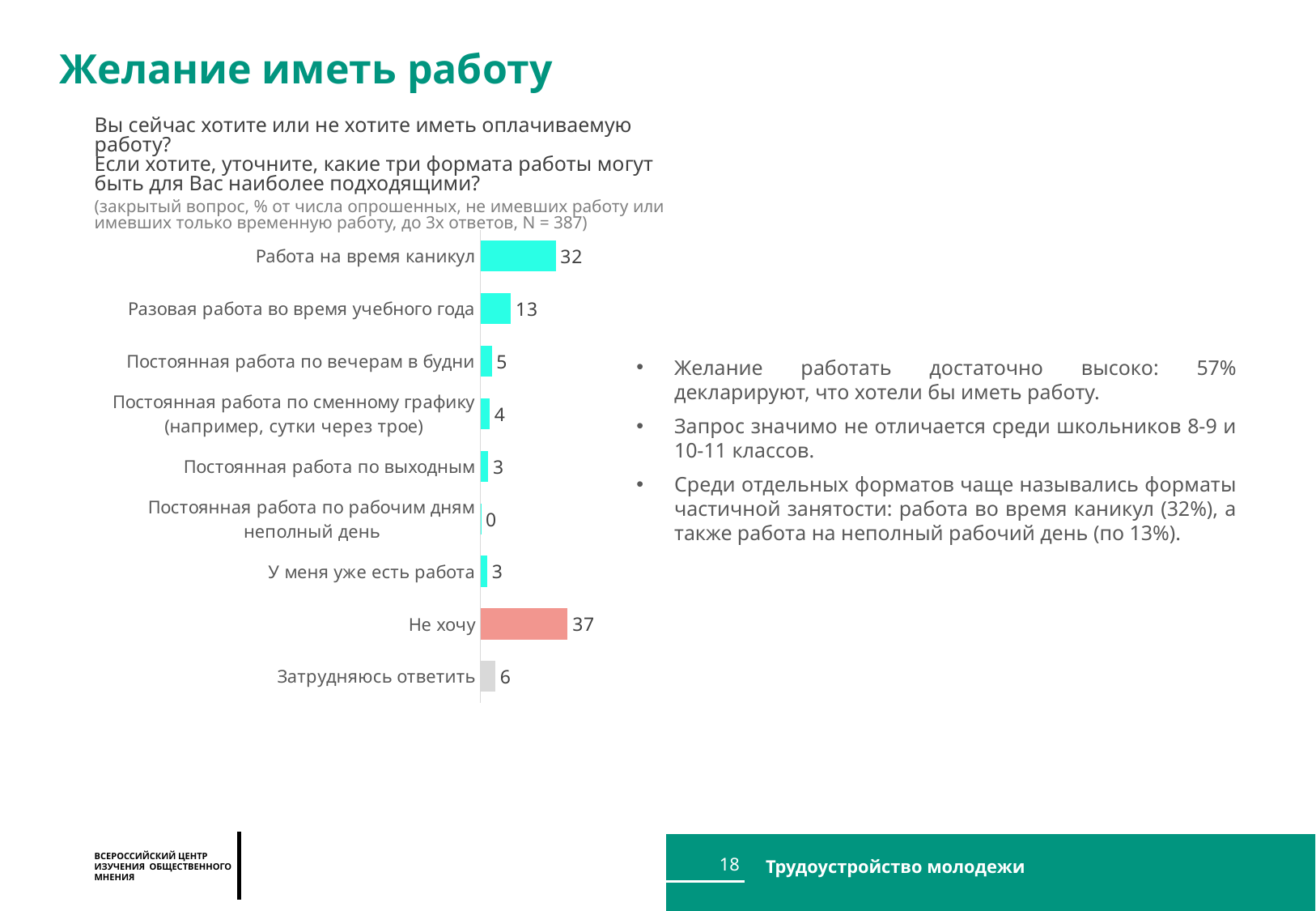
What kind of chart is shown on the slide? Bar chart What is the value for «Разовая работа во время учебного года»? 13 Which category has the highest value? Не хочу What colour is the bar for «Не хочу»? Pink (salmon) How many categories are shown in the chart? 9 Which category has the lowest value? Постоянная работа по рабочим дням неполный день What is the value for «Постоянная работа по рабочим дням неполный день»? 0 Which is larger: the value for «Постоянная работа по вечерам в будни» or «Постоянная работа по сменному графику (например, сутки через трое)»? Постоянная работа по вечерам в будни What is the value for «Затрудняюсь ответить»? 6 What is the value for «Не хочу»? 37 What is the difference between the values for «Не хочу» and «Работа на время каникул»? 5 What is the value for «Работа на время каникул»? 32